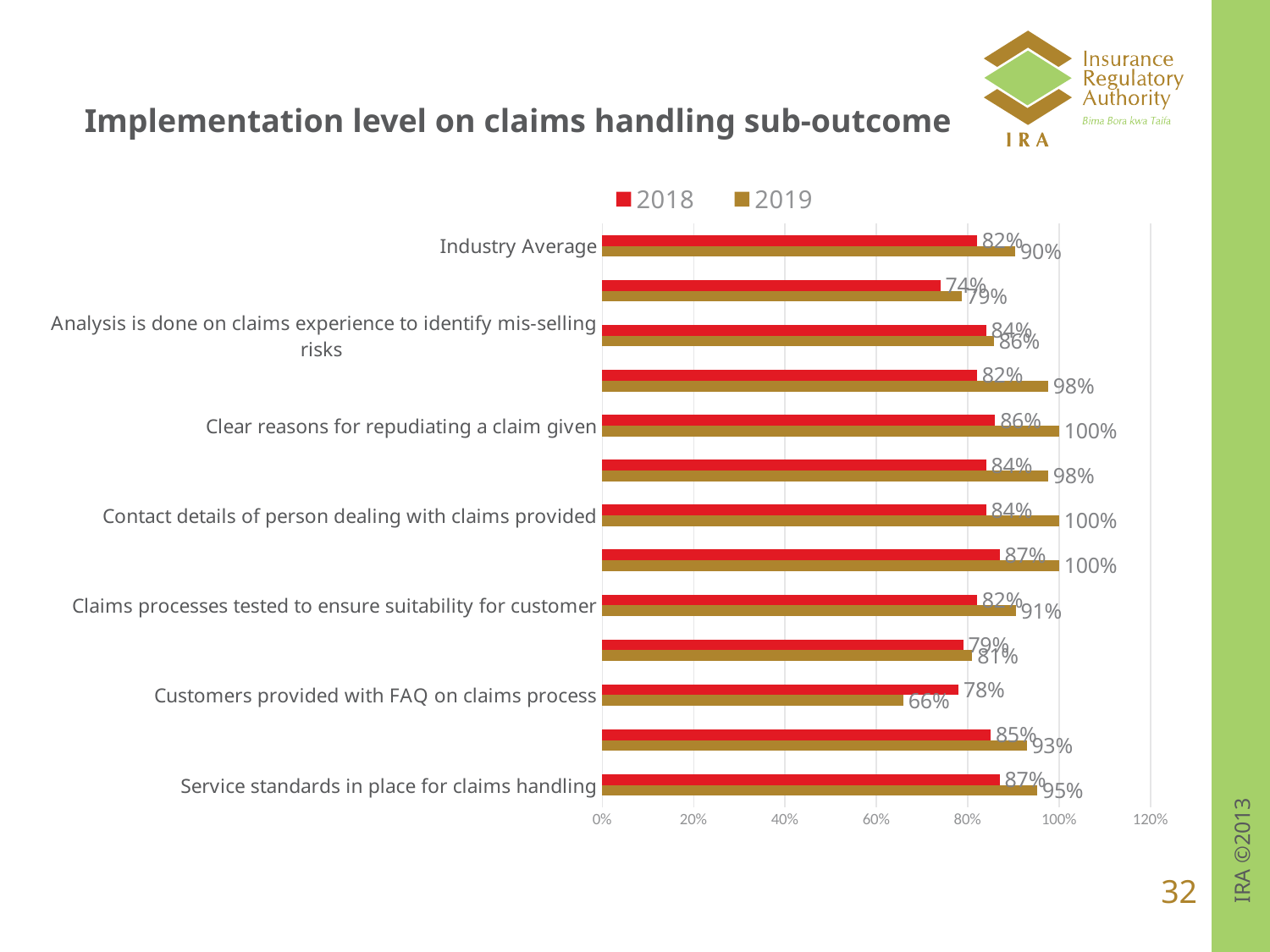
What is the difference between the 2019 and 2018 values for 'Claims processes tested to ensure suitability for customer'? 9% What kind of chart is shown on the slide? Bar chart For 'Customers provided with FAQ on claims process', which year has the larger value, 2018 or 2019? 2018 What is the 2019 value for 'Service standards in place for claims handling'? 95% What is the 2019 value for Industry Average? 90% How many series does the legend list? 2 What is the 2018 value for 'Contact details of person dealing with claims provided'? 84% Is the 2019 value for 'Analysis is done on claims experience to identify mis-selling risks' greater or less than 80%? greater What is the 2018 value for 'Customers provided with FAQ on claims process'? 78% What is the 2018 value for Industry Average? 82% What is the title of the chart on the slide? Implementation level on claims handling sub-outcome What is the 2019 value for 'Clear reasons for repudiating a claim given'? 100%